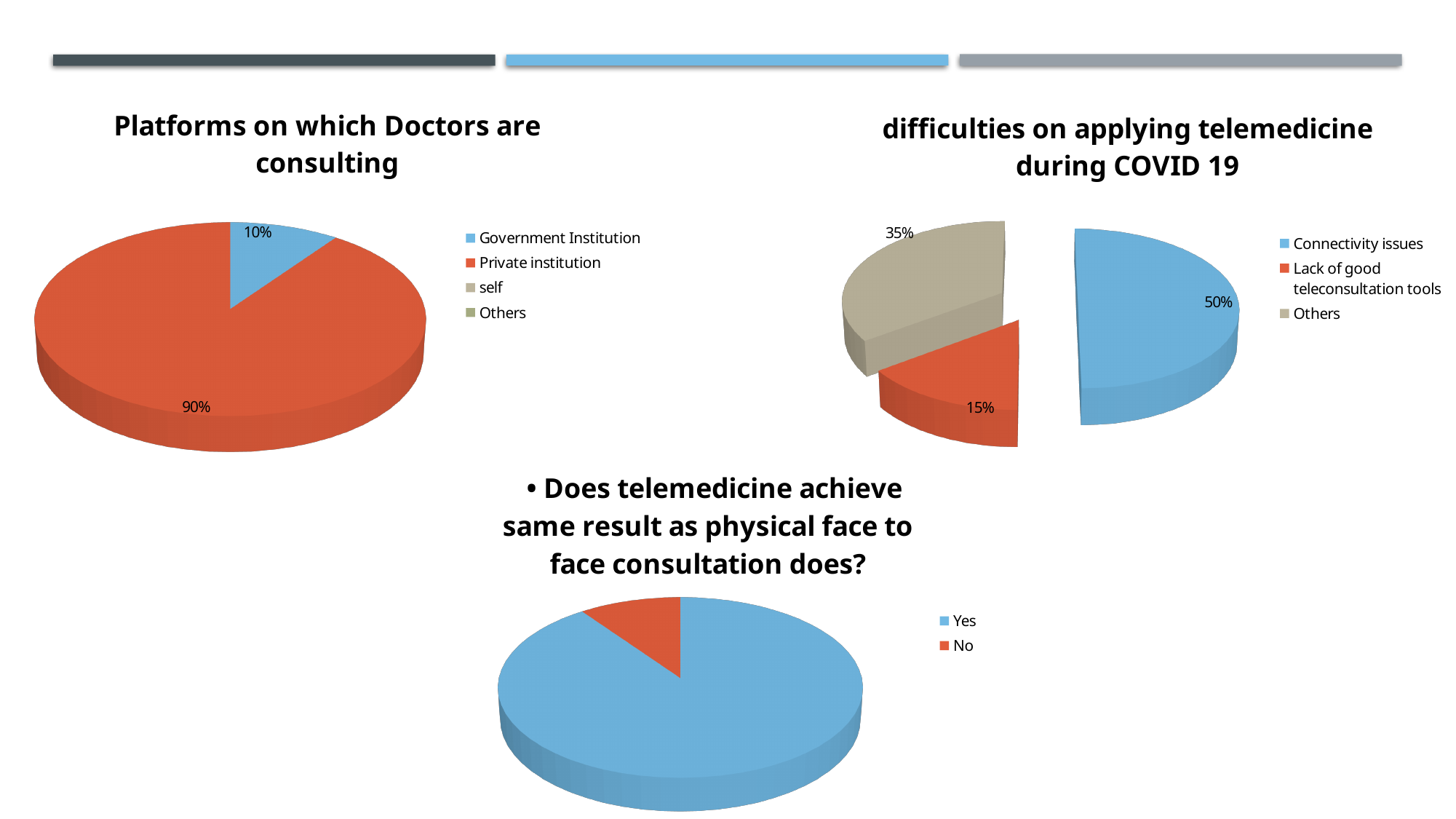
In the chart titled 'Platforms on which Doctors are consulting', what percentage is shown for Private institution? 90% In the chart titled 'Platforms on which Doctors are consulting', which category has the largest slice? Private institution In the chart titled 'difficulties on applying telemedicine during COVID 19', which is larger: Others or Lack of good teleconsultation tools? Others In the chart titled 'difficulties on applying telemedicine during COVID 19', what percentage is shown for Connectivity issues? 50% What kind of chart is used for the chart at the bottom of the slide about whether telemedicine achieves the same result as face to face consultation? Pie chart In the chart titled 'Platforms on which Doctors are consulting', what percentage is shown for Government Institution? 10% In the chart titled 'difficulties on applying telemedicine during COVID 19', what percentage is shown for Lack of good teleconsultation tools? 15% In the chart titled 'difficulties on applying telemedicine during COVID 19', which category has the smallest slice? Lack of good teleconsultation tools In the chart titled 'difficulties on applying telemedicine during COVID 19', what percentage is shown for Others? 35% In the chart at the bottom of the slide about whether telemedicine achieves the same result as face to face consultation, which slice is larger: Yes or No? Yes In the chart titled 'Platforms on which Doctors are consulting', how many entries does the legend list? 4 In the chart titled 'Platforms on which Doctors are consulting', what is the difference between the Private institution and Government Institution percentages? 80%